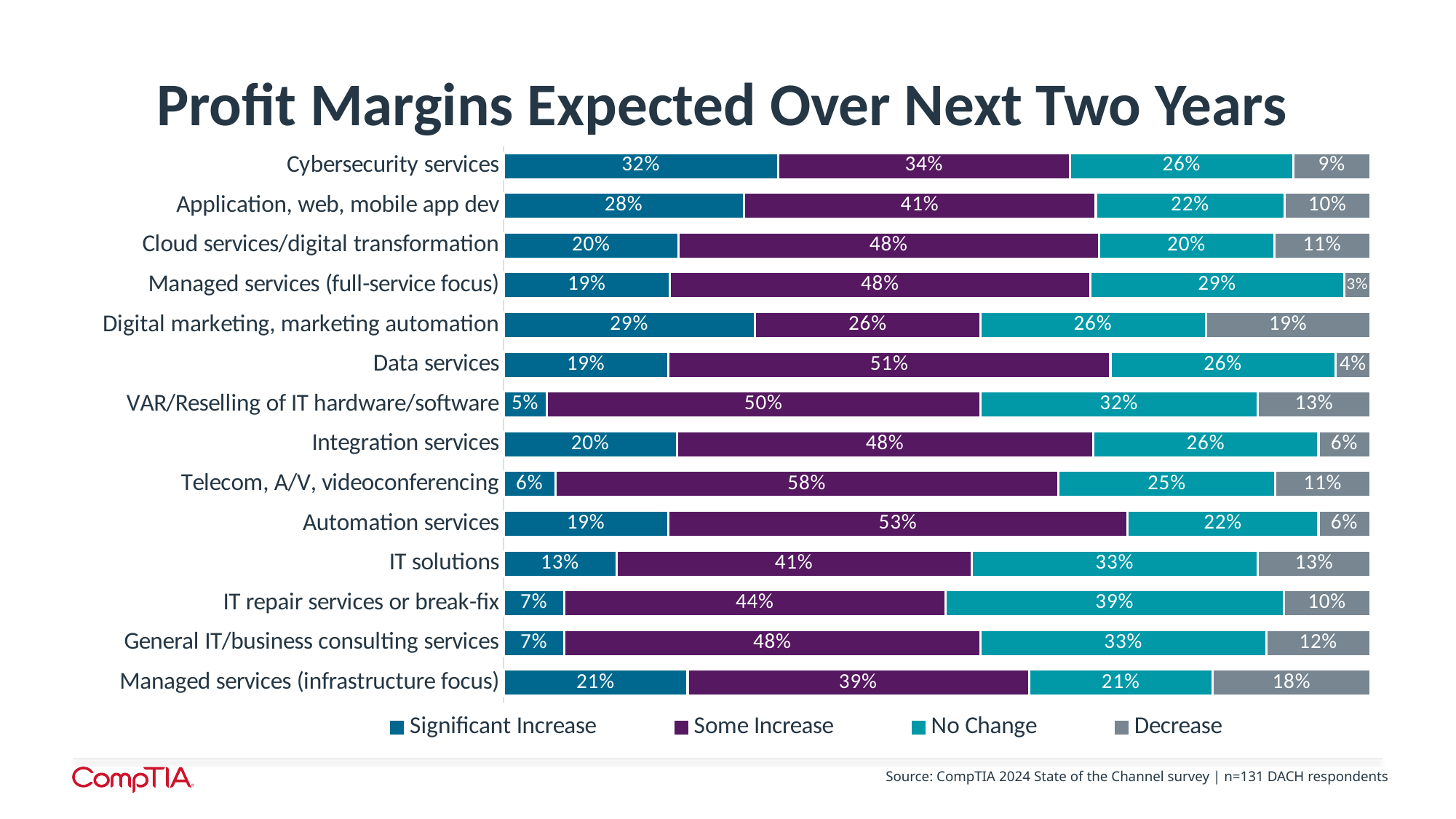
Which category has the lowest Decrease value? Managed services (full-service focus) Which category has the highest Significant Increase value? Cybersecurity services What is the Some Increase value for Telecom, A/V, videoconferencing? 58% What is the difference between the Some Increase values for Data services and IT solutions? 10% What type of chart is shown on the slide? Stacked bar chart Which category has the highest Decrease value? Digital marketing, marketing automation How many categories are shown in the chart? 14 Which category has the lowest Significant Increase value? VAR/Reselling of IT hardware/software What is the Decrease value for Managed services (infrastructure focus)? 18% Which is larger: the No Change value for IT repair services or break-fix, or the No Change value for Automation services? IT repair services or break-fix What percentage of respondents expect a Significant Increase in profit margins for Cybersecurity services? 32% How many series does the legend list? 4